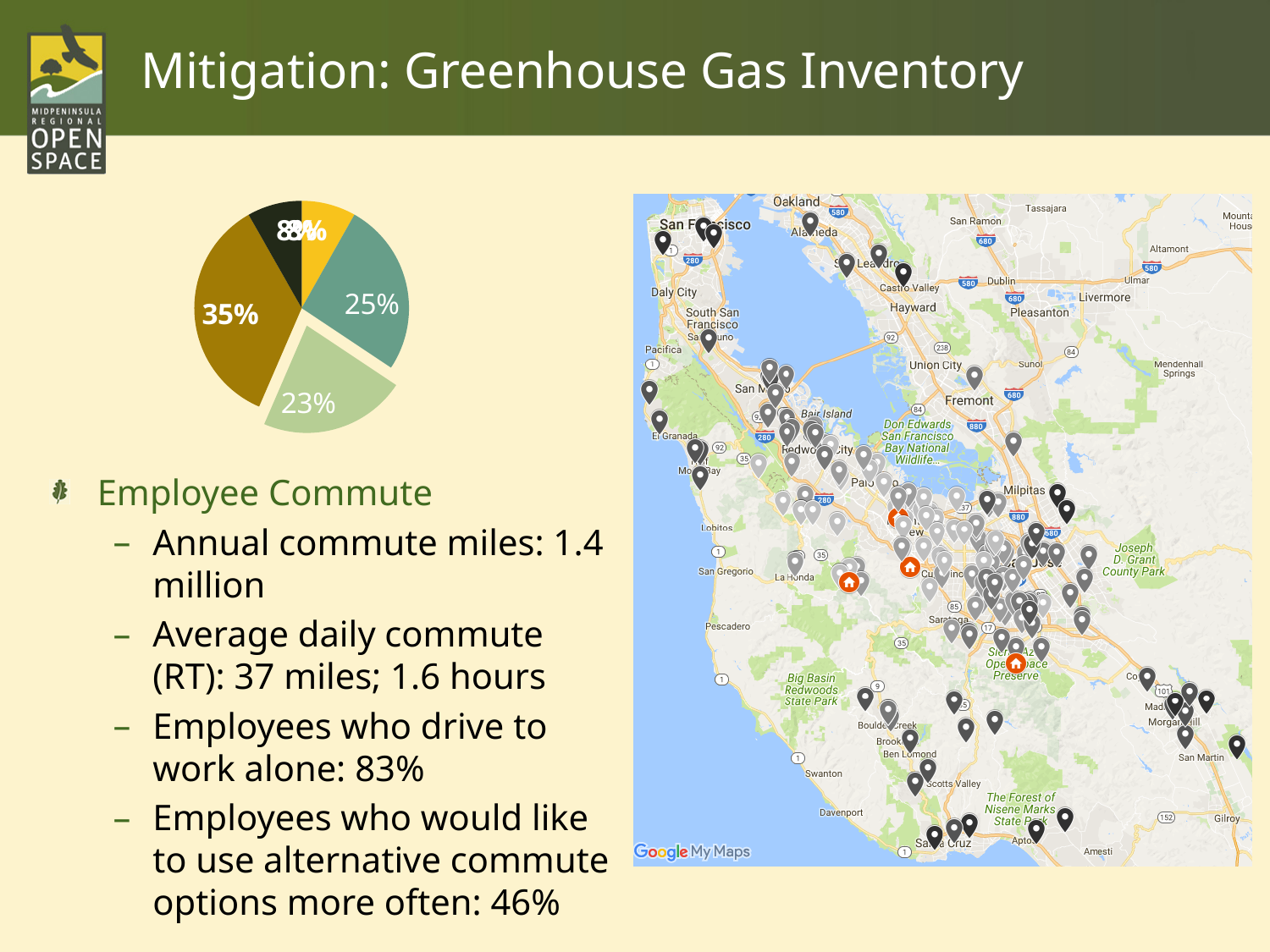
What is the largest percentage labelled on the pie chart? 35% Is the yellow slice of the pie chart greater or less than 20%? less What is the difference in percentage points between the 25% slice and the 23% slice on the pie chart? 2 What colour is the slice labelled 25% on the pie chart? teal green Is the dark gold slice of the pie chart greater or less than 30%? greater What is the difference in percentage points between the 35% slice and the 25% slice on the pie chart? 10 Which is larger on the pie chart, the slice labelled 25% or the slice labelled 23%? 25% What kind of chart is shown on the left of the slide? pie chart How many slices does the pie chart have? 5 What colour is the slice labelled 35% on the pie chart? dark gold